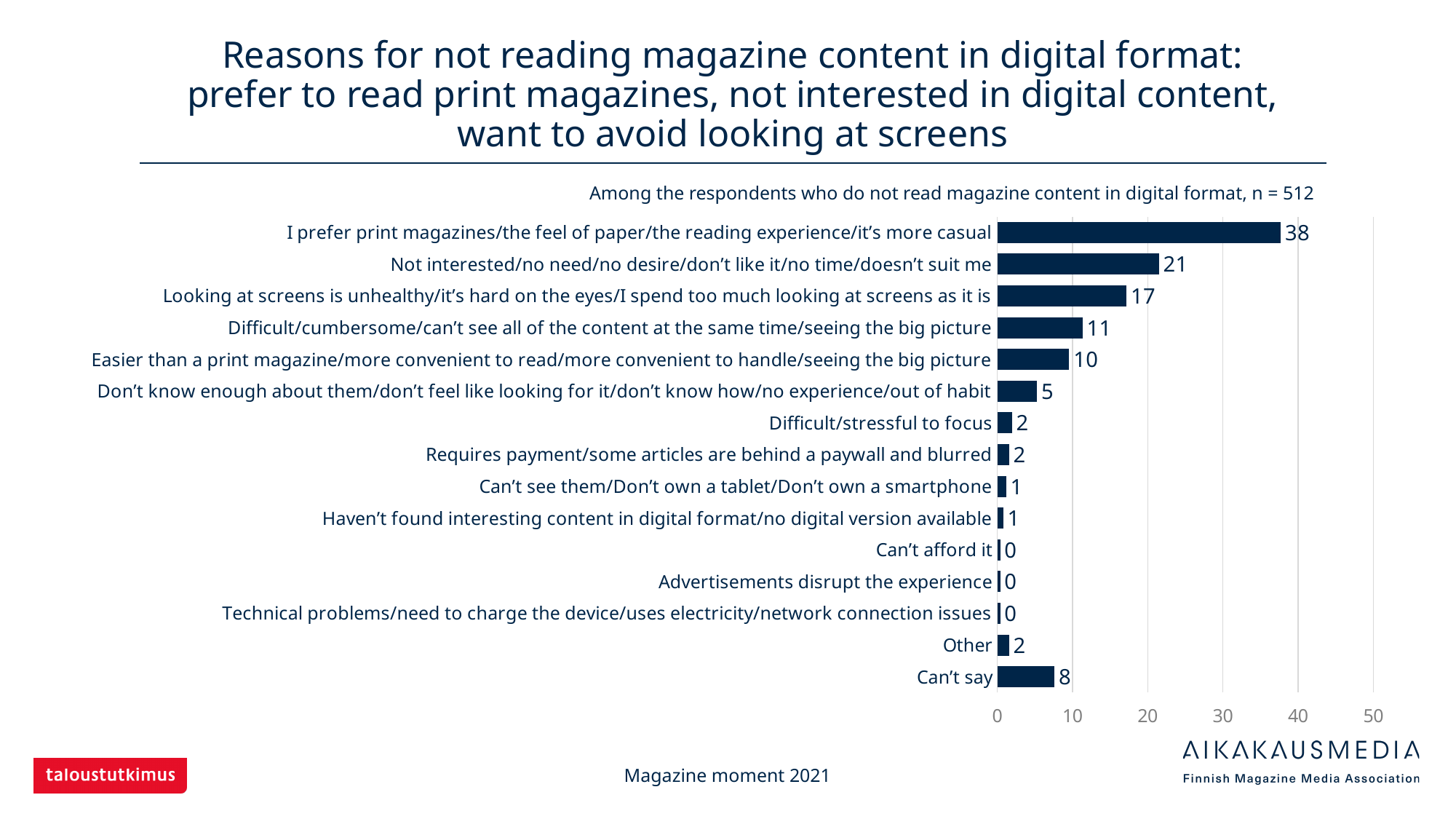
How many categories have a value of 0? 3 How many categories are shown in the chart? 15 What is the value for "Not interested/no need/no desire/don't like it/no time/doesn't suit me"? 21 What is the sample size (n) stated in the chart subtitle? 512 What is the value for "Looking at screens is unhealthy/it's hard on the eyes/I spend too much looking at screens as it is"? 17 What is the value for "Can't say"? 8 Which is larger: the value for "Difficult/cumbersome/can't see all of the content at the same time/seeing the big picture" or the value for "Can't say"? Difficult/cumbersome/can't see all of the content at the same time/seeing the big picture What kind of chart is shown on the slide? Bar chart Which category has the highest value? I prefer print magazines/the feel of paper/the reading experience/it's more casual What is the value for "Don't know enough about them/don't feel like looking for it/don't know how/no experience/out of habit"? 5 Is the value for "I prefer print magazines/the feel of paper/the reading experience/it's more casual" greater or less than 30? greater What is the difference between the values for "I prefer print magazines/the feel of paper/the reading experience/it's more casual" and "Not interested/no need/no desire/don't like it/no time/doesn't suit me"? 17